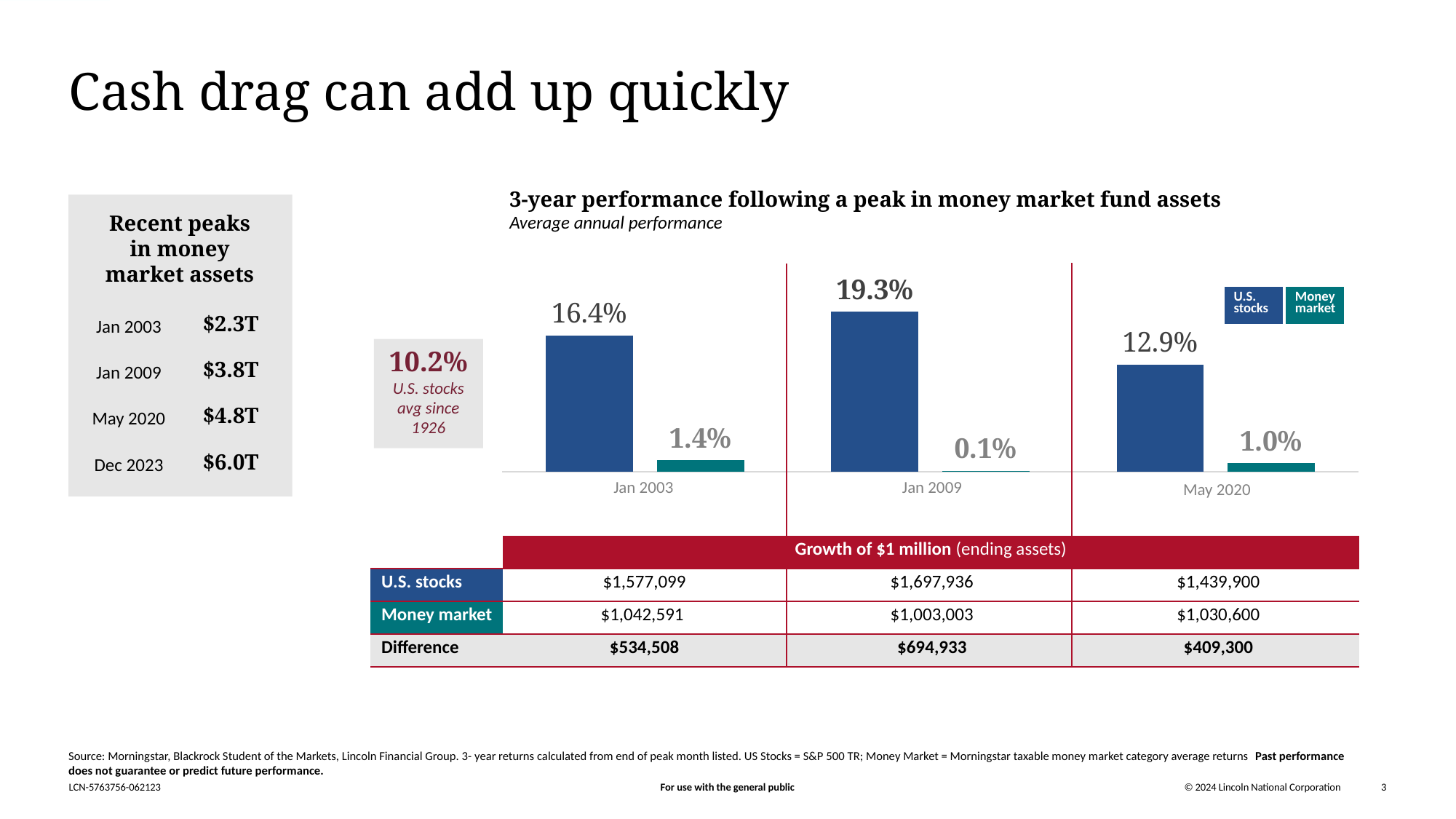
Which period has the highest U.S. stocks value? Jan 2009 How many periods are shown on the x axis of the chart? 3 What is the Money market value for Jan 2003? 1.4% What kind of chart is shown on the slide? Bar chart What is the U.S. stocks value for May 2020? 12.9% What is the difference between the U.S. stocks and Money market values for Jan 2003? 15.0% What is the U.S. stocks value for Jan 2009? 19.3% Which is larger, the U.S. stocks value for Jan 2003 or for May 2020? Jan 2003 How many series does the chart's legend list? 2 What is the Money market value for Jan 2009? 0.1% What is the title of the chart? 3-year performance following a peak in money market fund assets Which period has the lowest Money market value? Jan 2009